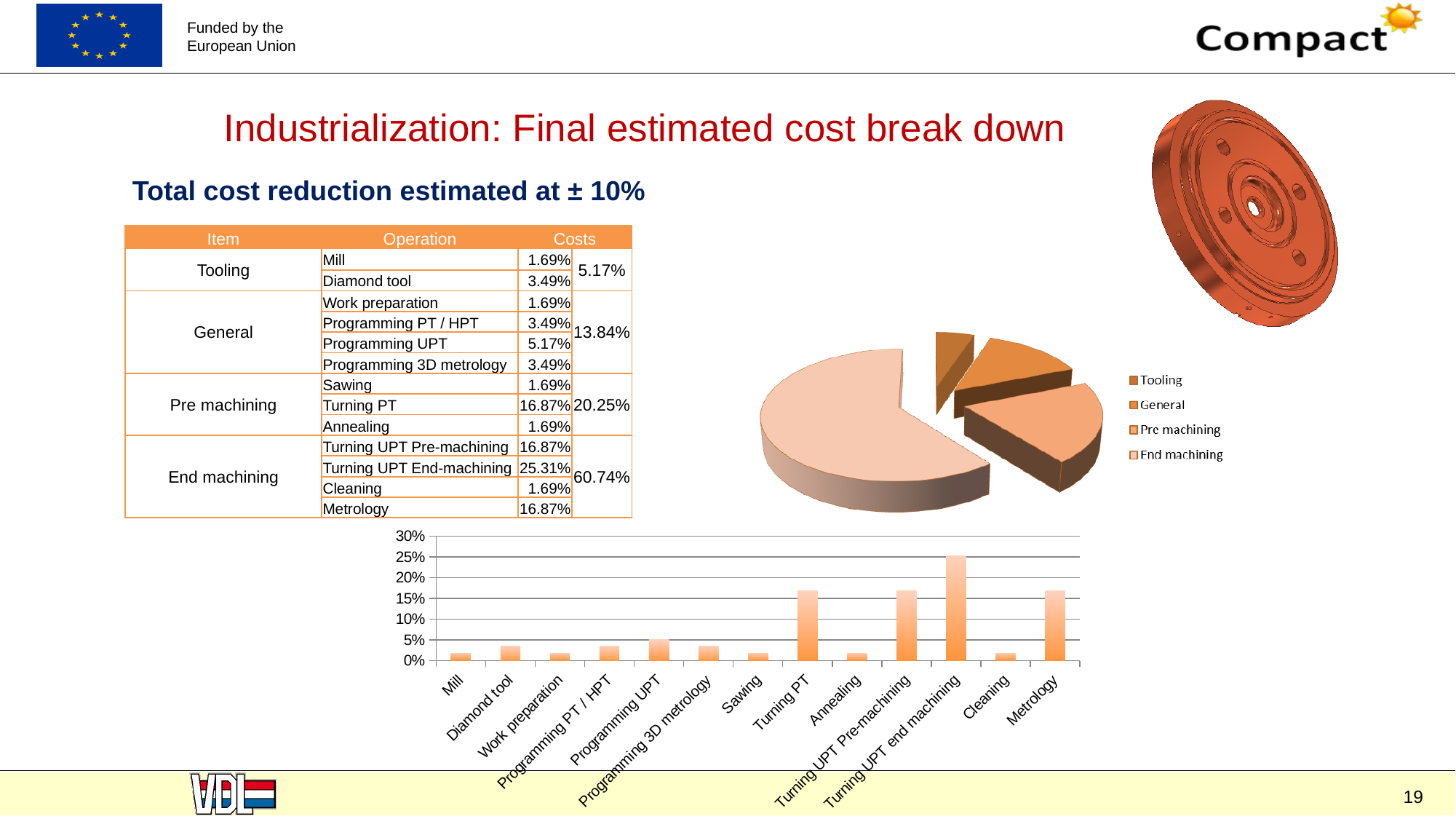
In the pie chart, which category has the largest slice? End machining In the pie chart, how many entries does the legend list? 4 In the bar chart at the bottom of the slide, is the value for Turning UPT end machining greater or less than 20%? greater What kind of chart is the chart in the middle right of the slide, next to the table? pie chart In the pie chart, which category has the smallest slice? Tooling In the bar chart at the bottom of the slide, is the value for Metrology greater or less than 20%? less In the bar chart at the bottom of the slide, which category has the highest bar? Turning UPT end machining What kind of chart is the chart at the bottom of the slide? bar chart In the bar chart at the bottom of the slide, which is larger, the value for Turning PT or the value for Programming UPT? Turning PT In the bar chart at the bottom of the slide, how many categories are shown on the x axis? 13 In the bar chart at the bottom of the slide, is the value for Turning PT greater or less than 15%? greater